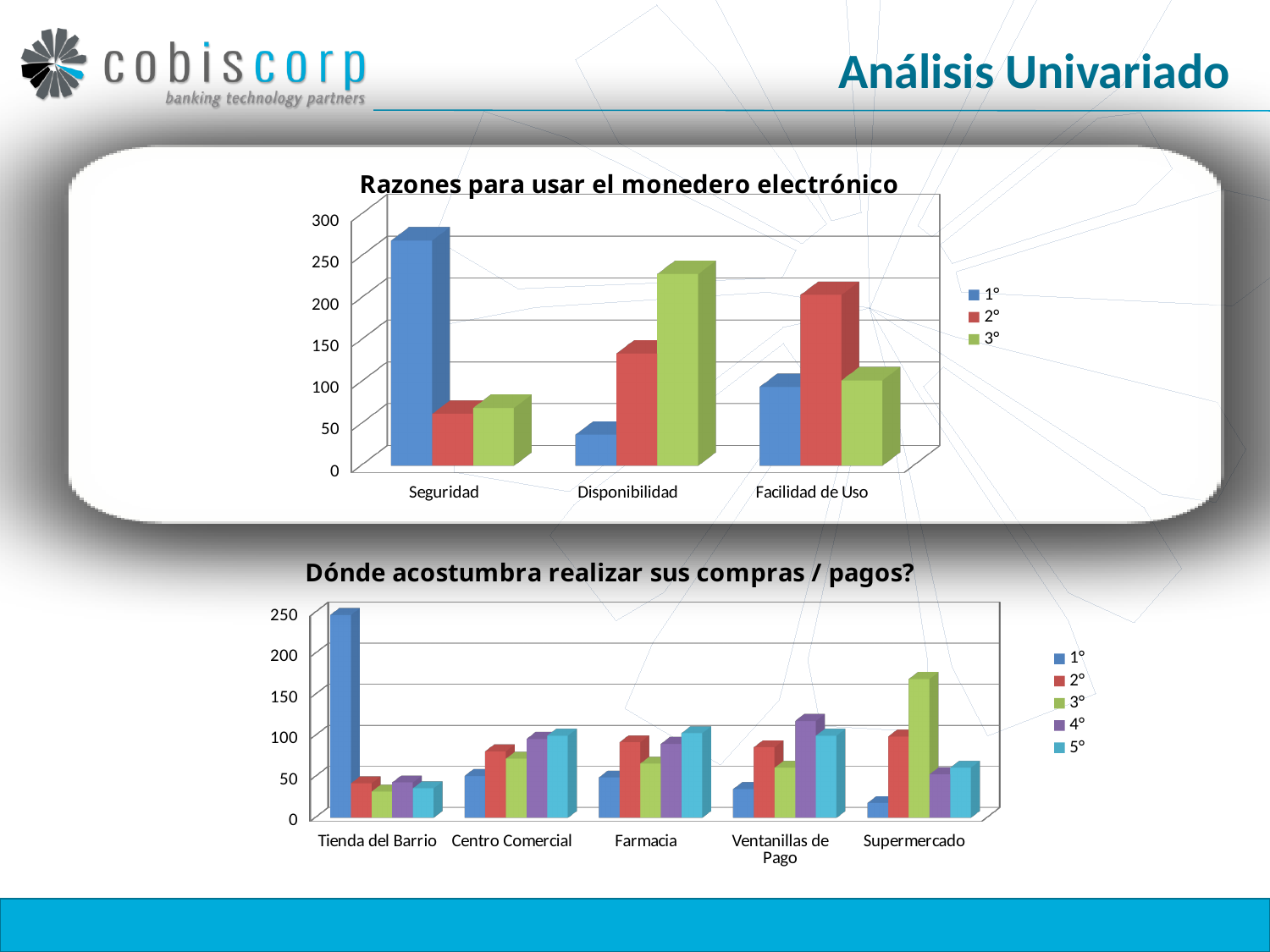
In the bottom chart 'Dónde acostumbra realizar sus compras / pagos?', how many categories are shown on the x axis? 5 In the top chart 'Razones para usar el monedero electrónico', which category has the highest value for the 1° series? Seguridad In the top chart 'Razones para usar el monedero electrónico', is the 1° value for Seguridad greater or less than 250? greater In the top chart 'Razones para usar el monedero electrónico', how many series does the legend list? 3 In the bottom chart 'Dónde acostumbra realizar sus compras / pagos?', how many series does the legend list? 5 In the top chart 'Razones para usar el monedero electrónico', is the 1° value for Disponibilidad greater or less than 50? less In the bottom chart 'Dónde acostumbra realizar sus compras / pagos?', is the 1° value for Tienda del Barrio greater or less than 200? greater What kind of chart is the top chart, 'Razones para usar el monedero electrónico'? bar chart In the top chart 'Razones para usar el monedero electrónico', how many categories are shown on the x axis? 3 In the bottom chart 'Dónde acostumbra realizar sus compras / pagos?', which category has the highest value for the 3° series? Supermercado In the top chart 'Razones para usar el monedero electrónico', for Facilidad de Uso, which series has the larger value, 2° or 3°? 2°